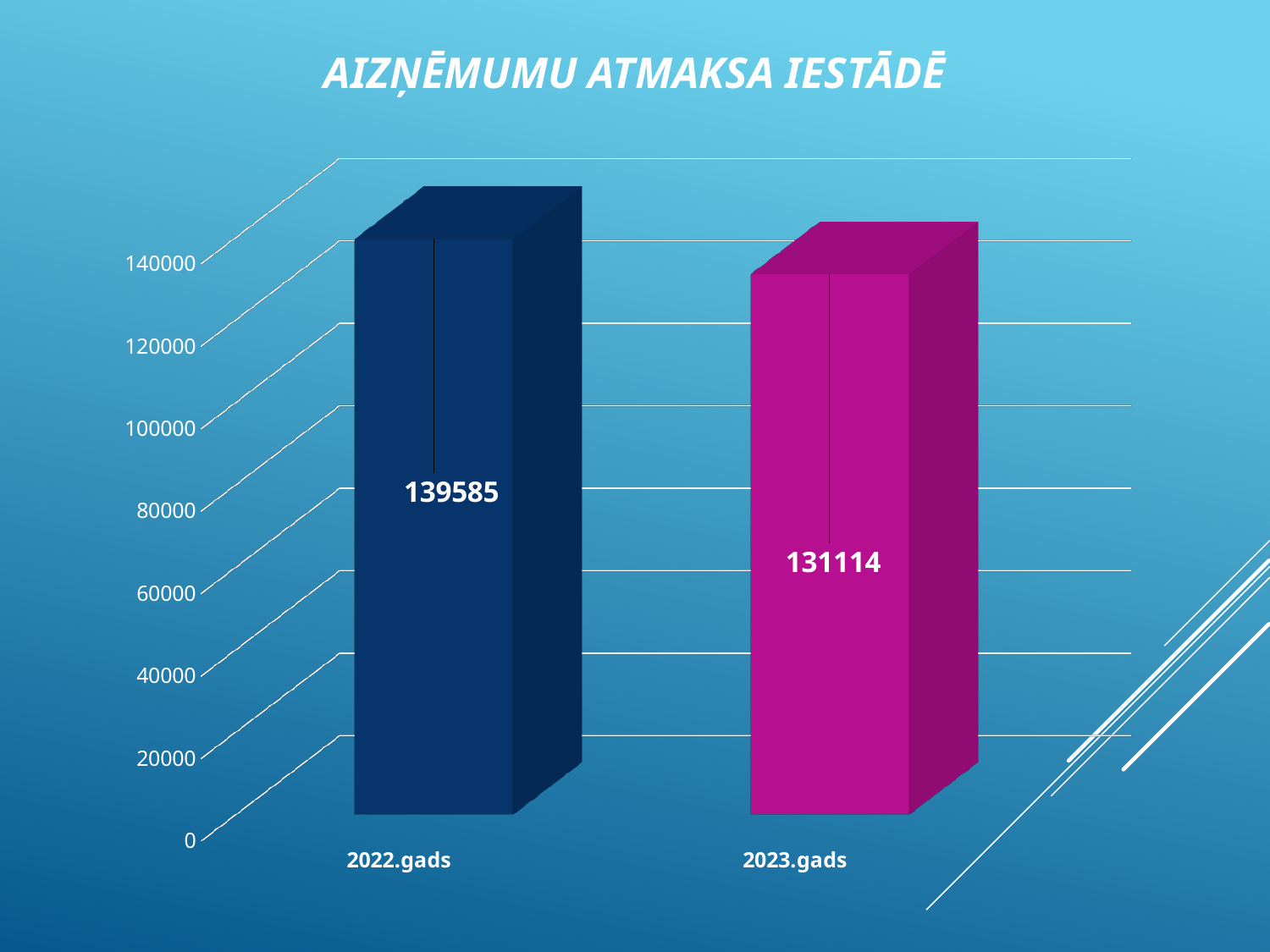
Do the values rise or fall from 2022.gads to 2023.gads? fall What is the title of the chart? AIZŅĒMUMU ATMAKSA IESTĀDĒ Which is larger, the value for 2022.gads or 2023.gads? 2022.gads Which year has the highest value? 2022.gads Which year has the lowest value? 2023.gads What is the value for 2022.gads? 139585 What is the difference between the values for 2022.gads and 2023.gads? 8471 How many categories are shown on the chart? 2 Is the value for 2022.gads greater or less than 140000? less What is the value for 2023.gads? 131114 Is the value for 2023.gads greater or less than 120000? greater What kind of chart is shown on the slide? bar chart